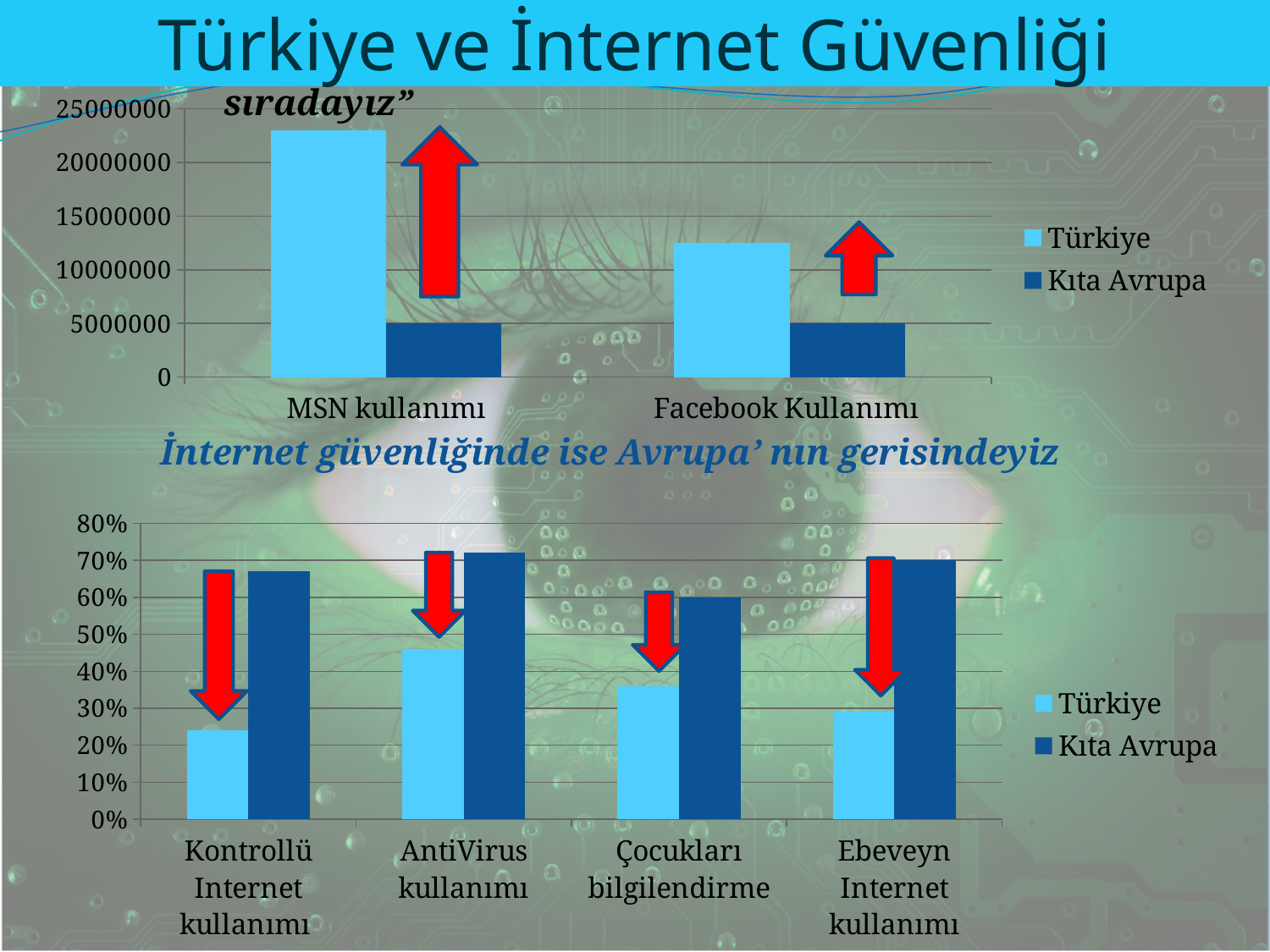
In the bottom chart, is the Türkiye value for AntiVirus kullanımı greater or less than 40%? greater In the top chart, which category has the higher Türkiye value, MSN kullanımı or Facebook Kullanımı? MSN kullanımı In the bottom chart, which category has the highest Kıta Avrupa value? AntiVirus kullanımı How many categories are shown on the x axis of the bottom chart? 4 In the top chart, is the Türkiye value for MSN kullanımı greater or less than 20000000? greater In the bottom chart, which category has the lowest Türkiye value? Kontrollü Internet kullanımı How many categories are shown on the x axis of the top chart? 2 What are the two legend entries of the top chart? Türkiye and Kıta Avrupa How many series does the legend of the bottom chart list? 2 What kind of chart is the top chart on the slide? bar chart In the top chart, is the Türkiye value for Facebook Kullanımı greater or less than 15000000? less In the bottom chart, which series is higher for Ebeveyn Internet kullanımı, Türkiye or Kıta Avrupa? Kıta Avrupa